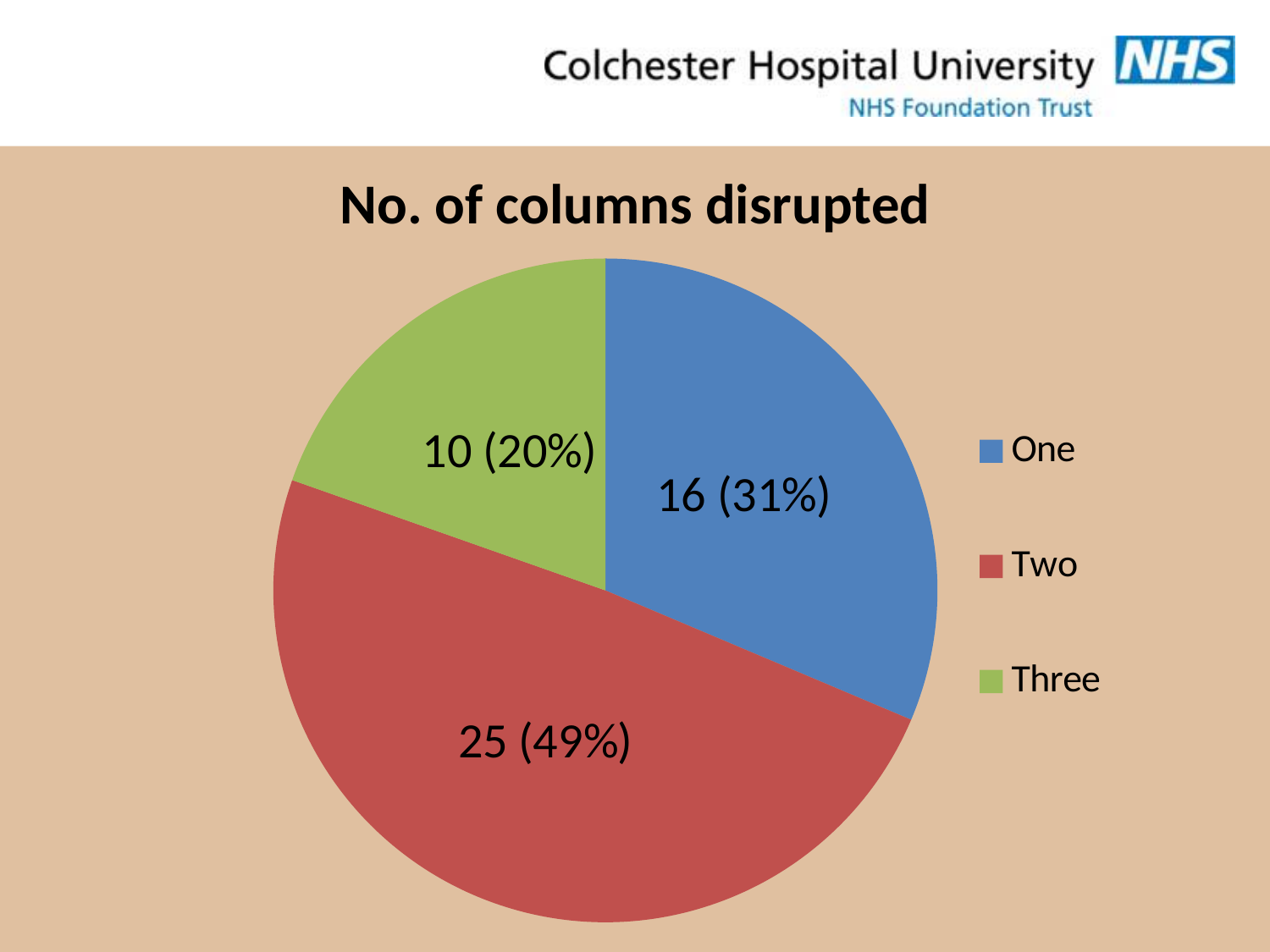
What is the difference in count between the 'Two' and 'One' slices? 9 What is the data label for the 'One' slice? 16 (31%) What is the title of the chart? No. of columns disrupted What is the data label for the 'Three' slice? 10 (20%) Which category has the largest slice? Two What is the data label for the 'Two' slice? 25 (49%) What kind of chart is shown on the slide? pie chart How many entries does the legend list? 3 What share of the pie does the 'Two' slice represent? 49% How many slices does the pie chart have? 3 Which category has the smallest slice? Three Which colour represents the 'Three' category in the legend? green